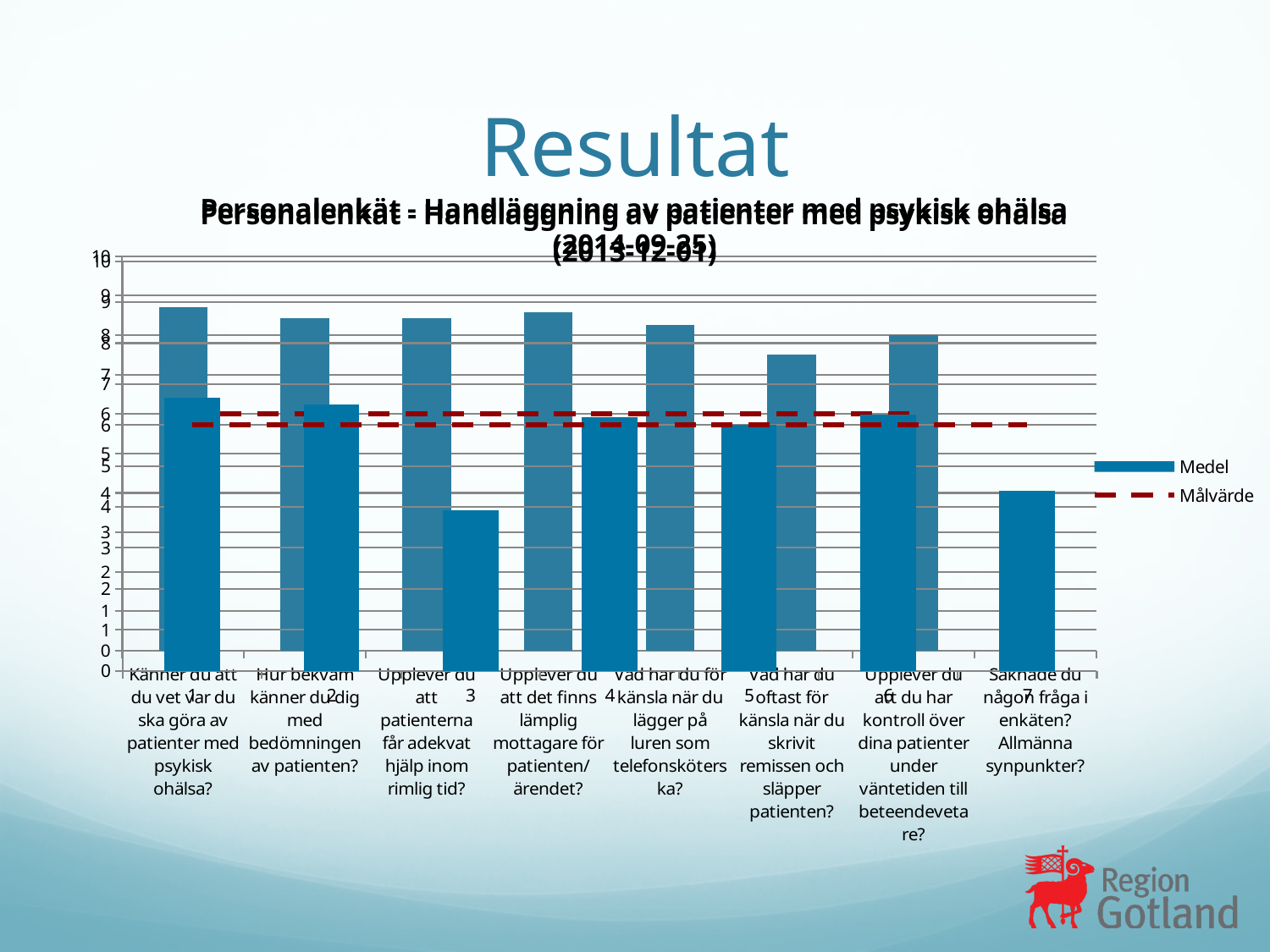
In the chart with numbered categories 1 to 7, is the value for category 6 greater or less than 7? less What kind of chart is shown on the slide? combination bar and line chart In the chart with numbered categories 1 to 7, which category has the lowest bar? 3 How many series does the legend list? 2 In the chart with text category labels, is the value for 'Känner du att du vet var du ska göra av patienter med psykisk ohälsa?' greater or less than 6? greater In the chart with text category labels, is the value for 'Upplever du att patienterna får adekvat hjälp inom rimlig tid?' greater or less than 5? greater What two entries does the legend list? Medel, Målvärde In the chart with numbered categories 1 to 7, how many categories are plotted? 7 At what value does the dashed Målvärde line sit on the y axis? 6